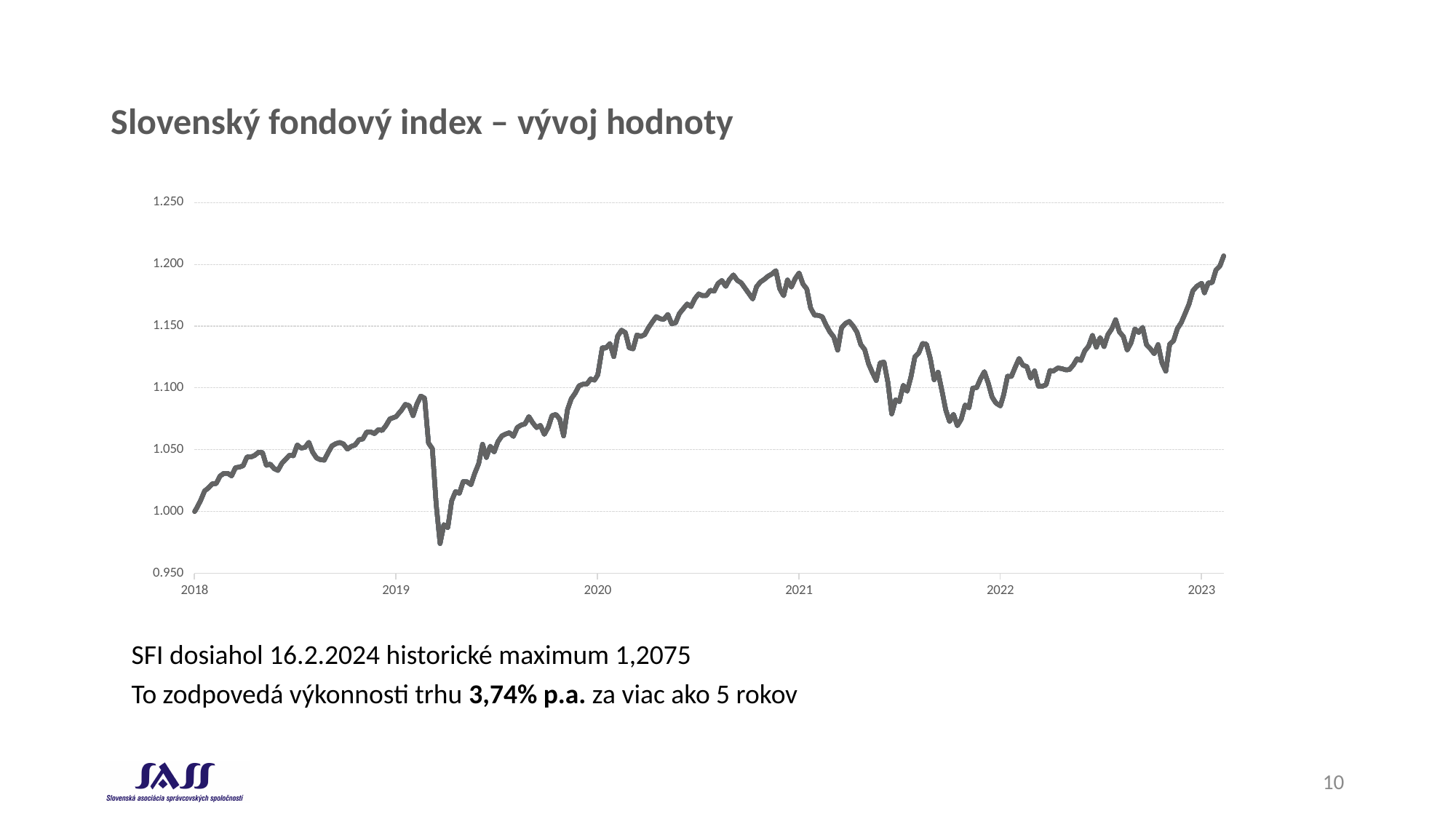
What is the highest value shown on the y axis? 1.250 What kind of chart is shown on the slide? line chart In which year does the line reach its highest point? 2024 What is the title of the chart? Slovenský fondový index – vývoj hodnoty Is the value of the index at the start of 2023 greater or less than 1.150? greater Does the index overall rise or fall from 2018 to the end of the chart? rise Is the lowest point of the index in 2019 greater or less than 1.000? less What is the value of the index at the start of 2018? 1.000 How many year labels are shown on the x axis? 6 Is the value of the index at the start of 2021 greater or less than 1.150? greater Which is higher, the index value at the start of 2021 or at the start of 2022? start of 2021